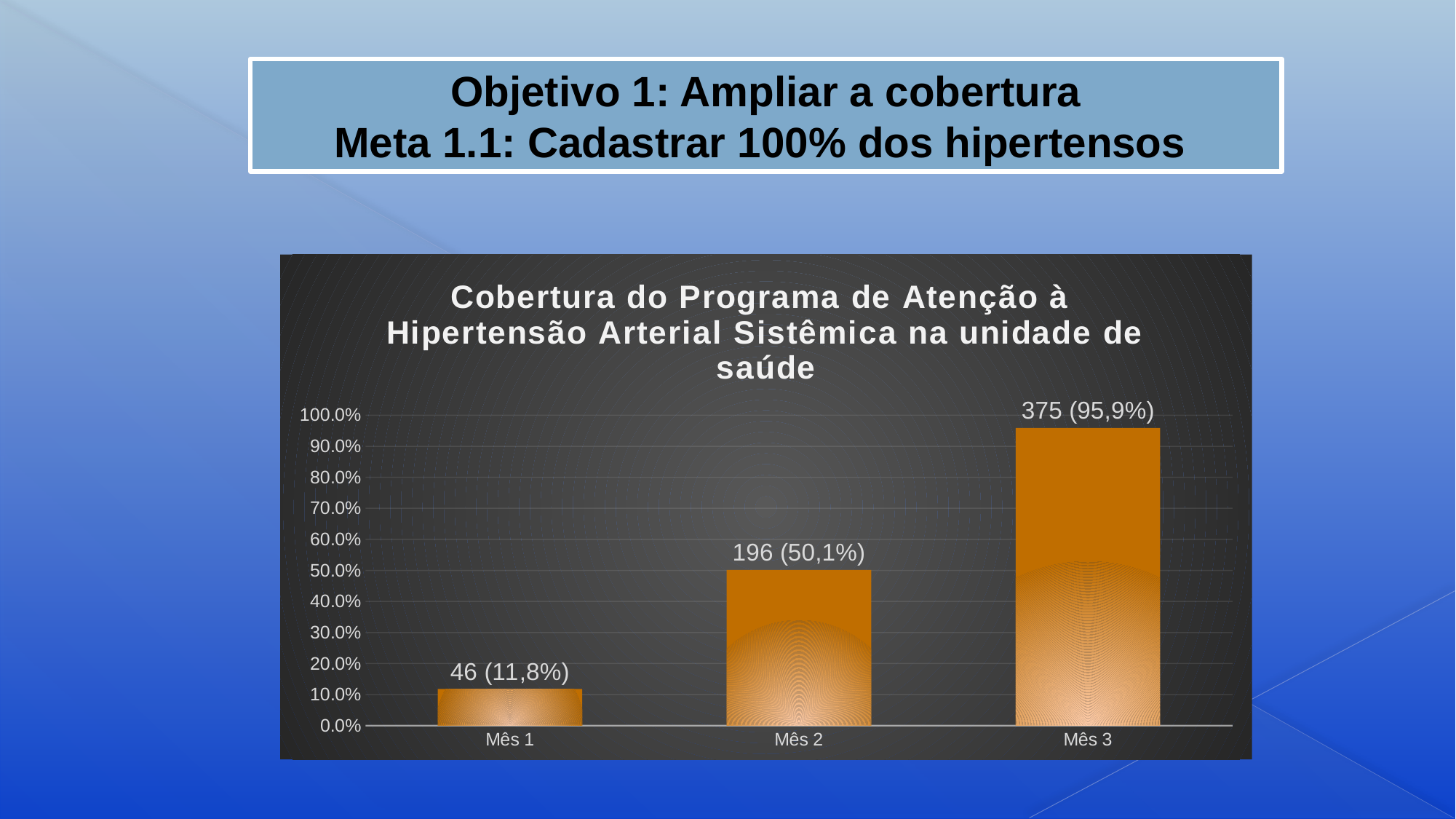
Do the values rise or fall from Mês 1 to Mês 3? Rise How many months are shown on the x axis? 3 Which month has the lowest coverage? Mês 1 What kind of chart is shown on the slide? Bar chart What is the difference in the number of registered patients between Mês 3 and Mês 2? 179 Which month has the highest coverage? Mês 3 What is the data label shown for Mês 2? 196 (50,1%) What is the data label shown for Mês 1? 46 (11,8%) Which is larger, the coverage for Mês 2 or for Mês 1? Mês 2 What is the difference in coverage percentage between Mês 2 and Mês 1? 38,3% What is the data label shown for Mês 3? 375 (95,9%) Is the value for Mês 3 greater or less than 90%? greater